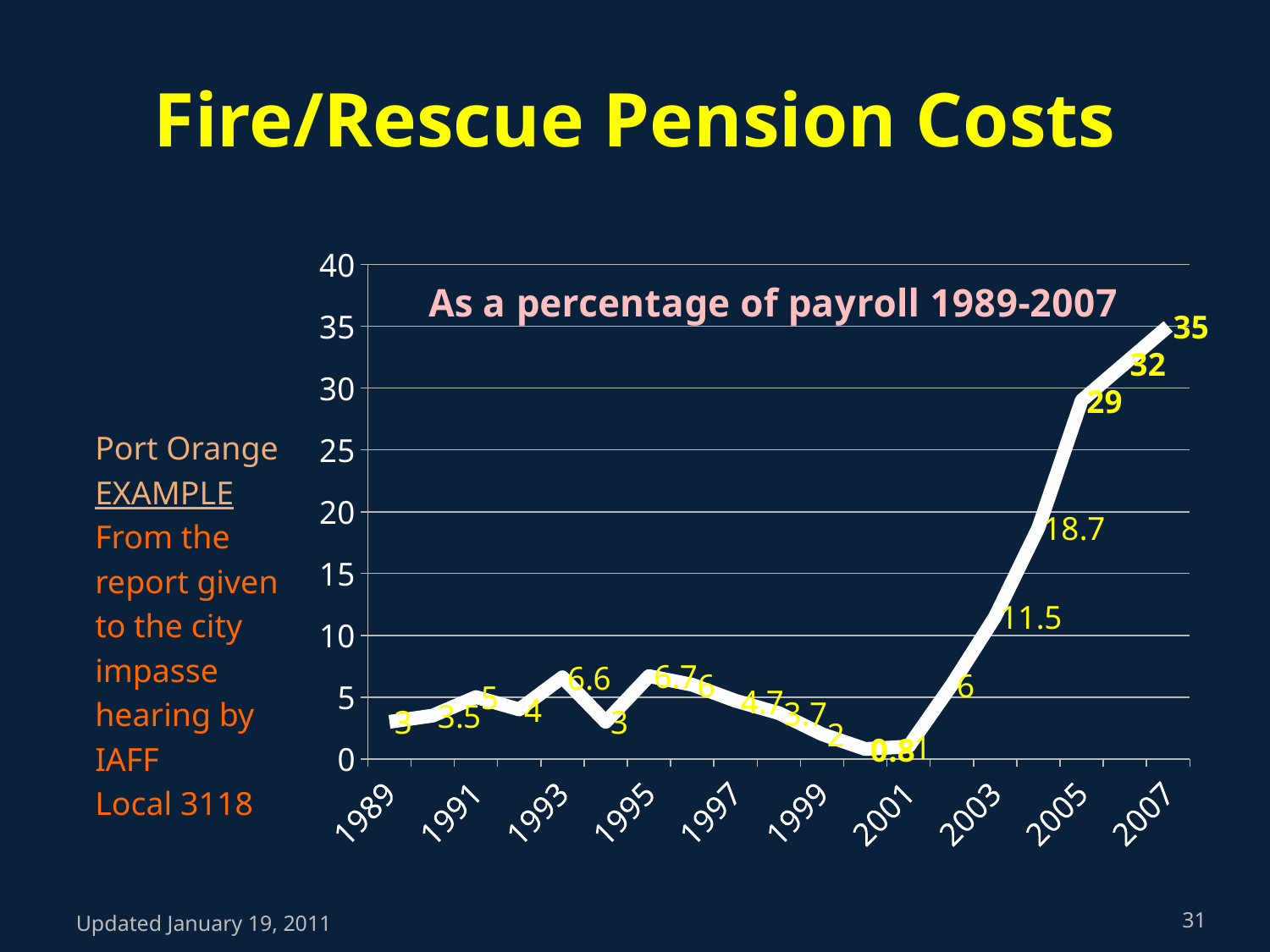
What kind of chart is shown on the slide? line chart What is the value plotted for 2005? 29 Is the value for 2005 greater or less than 25? greater Do the values rise or fall between 2001 and 2007? rise What is the title printed inside the chart area? As a percentage of payroll 1989-2007 What is the lowest value labelled on the line? 0.8 What is the value plotted for 1989? 3 What is the Fire/Rescue pension cost as a percentage of payroll in 2007? 35 Which year has the highest pension cost as a percentage of payroll? 2007 What is the value plotted for 2003? 11.5 Which year has the larger value, 1997 or 2003? 2003 By how much did the value increase from 2005 to 2007? 6